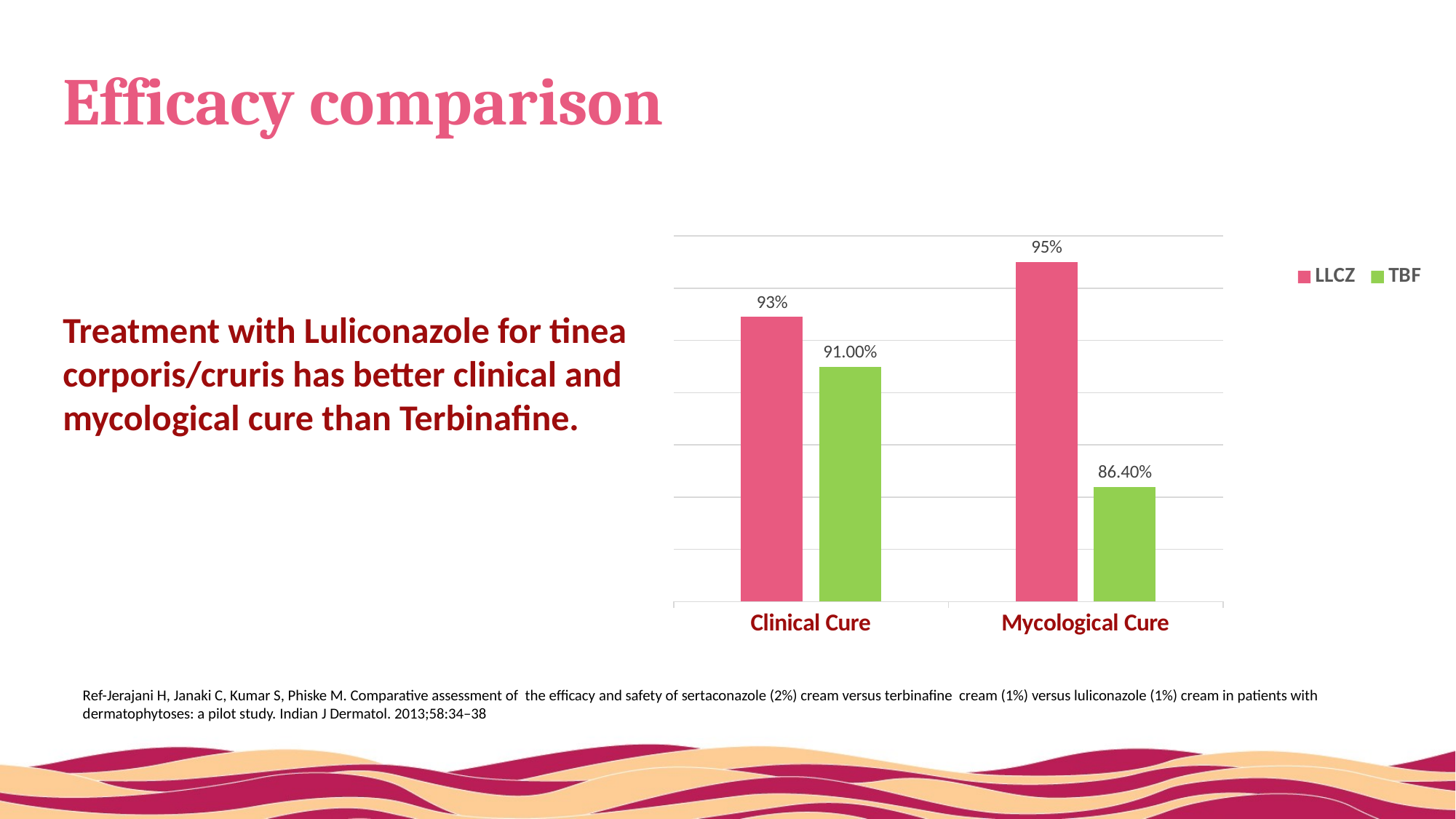
How many series does the chart legend list? 2 What is the TBF value for Mycological Cure? 86.40% What is the difference between the LLCZ and TBF values for Mycological Cure? 8.6 percentage points What is the LLCZ value for Mycological Cure? 95% How many categories are shown on the x axis of the chart? 2 Which bar in the chart has the lowest value? TBF for Mycological Cure What is the LLCZ value for Clinical Cure? 93% What is the difference between the LLCZ and TBF values for Clinical Cure? 2 percentage points What type of chart is shown on the slide? Bar chart What is the TBF value for Clinical Cure? 91.00% For Mycological Cure, which series has the larger value, LLCZ or TBF? LLCZ Which bar in the chart has the highest value? LLCZ for Mycological Cure